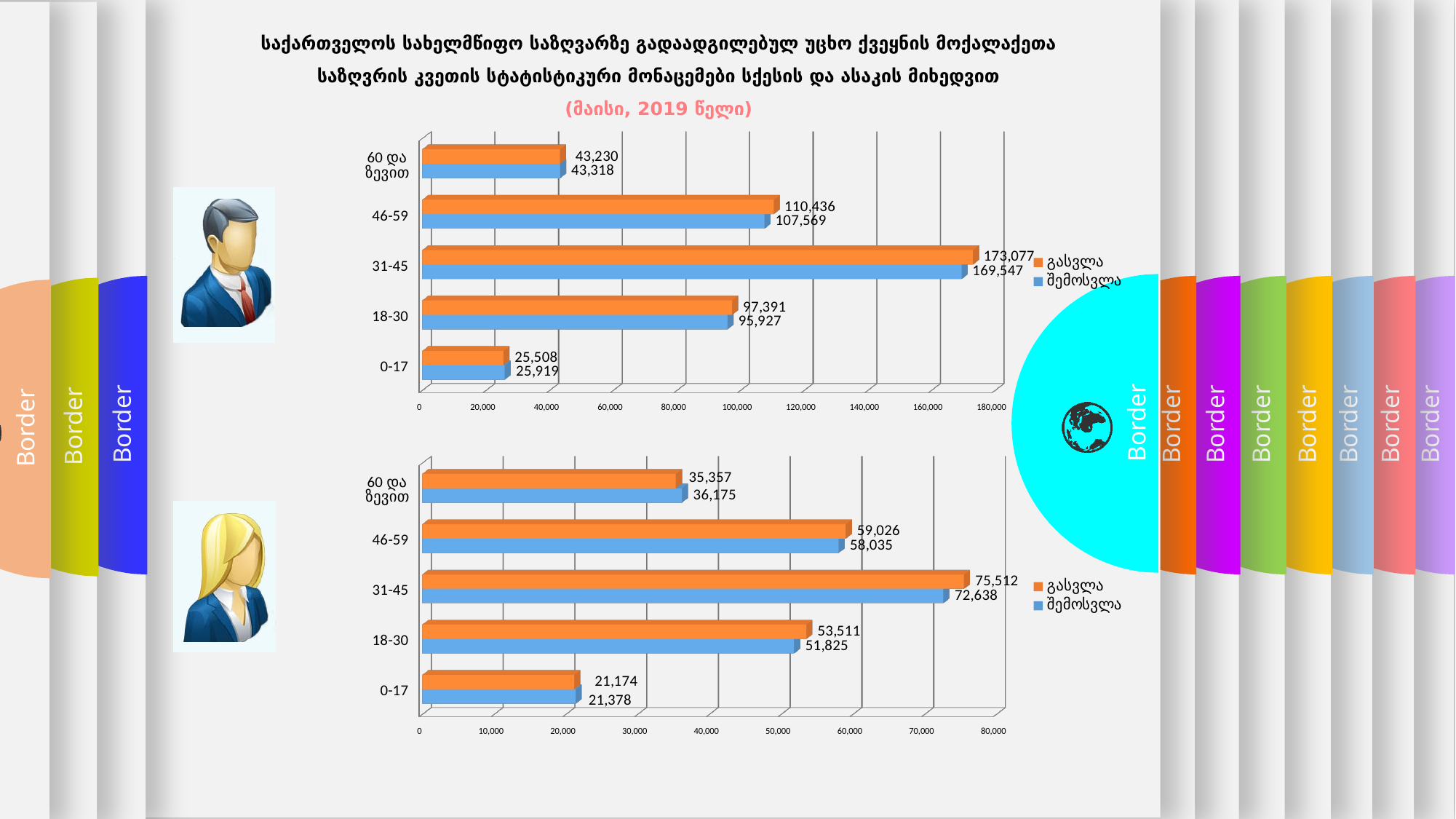
On the top chart, which is larger: the გასვლა value for 46-59 or the გასვლა value for 18-30? 46-59 On the bottom chart, what is the გასვლა value for the 18-30 age group? 53,511 On the bottom chart, what is the შემოსვლა value for the 0-17 age group? 21,378 On the top chart, what is the difference between the გასვლა and შემოსვლა values for the 31-45 age group? 3,530 On the bottom chart, which age group has the lowest შემოსვლა value? 0-17 What type of chart is the bottom chart? Bar chart On the top chart, which age group has the highest გასვლა value? 31-45 On the top chart, what is the გასვლა value for the 31-45 age group? 173,077 How many age groups are shown on the bottom chart? 5 How many series does the legend of the top chart list? 2 On the top chart, what is the შემოსვლა value for the 46-59 age group? 107,569 On the bottom chart, what is the difference between the გასვლა values for the 46-59 and 18-30 age groups? 5,515